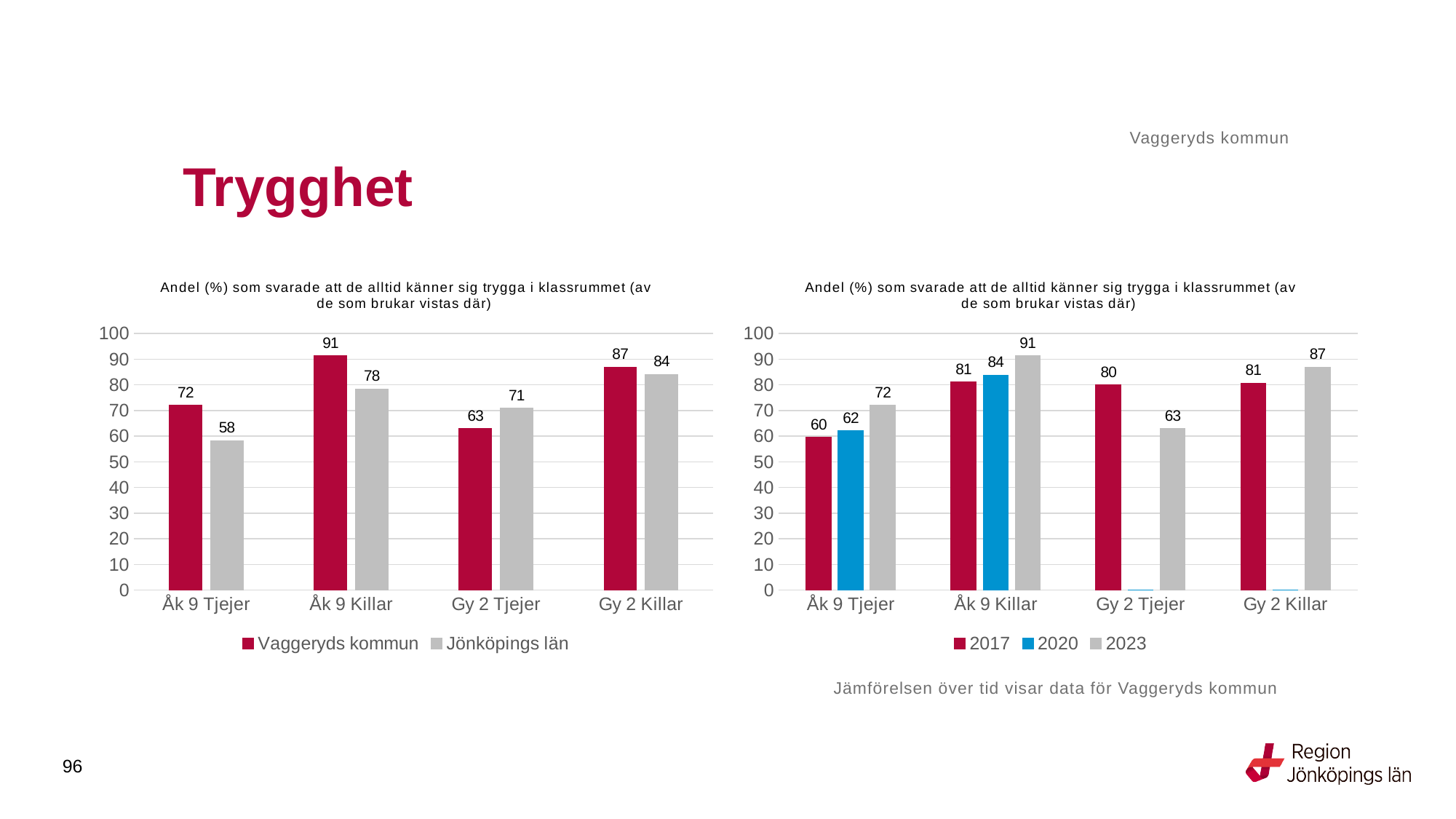
In the right chart, which category has the highest value for 2023? Åk 9 Killar In the left chart, which is larger for Gy 2 Killar: Vaggeryds kommun or Jönköpings län? Vaggeryds kommun In the left chart, which category has the lowest value for Jönköpings län? Åk 9 Tjejer In the left chart, what is the value for Jönköpings län for Åk 9 Tjejer? 58 In the right chart, how many series does the legend list? 3 In the right chart, what is the value for 2017 for Gy 2 Tjejer? 80 In the right chart, what is the difference between the 2023 and 2017 values for Åk 9 Tjejer? 12 In the left chart, what is the difference between Vaggeryds kommun and Jönköpings län for Gy 2 Tjejer? 8 What kind of chart is the right chart? Bar chart In the right chart, what is the value for 2020 for Åk 9 Killar? 84 In the left chart, how many series does the legend list? 2 In the left chart, what is the value for Vaggeryds kommun for Åk 9 Killar? 91